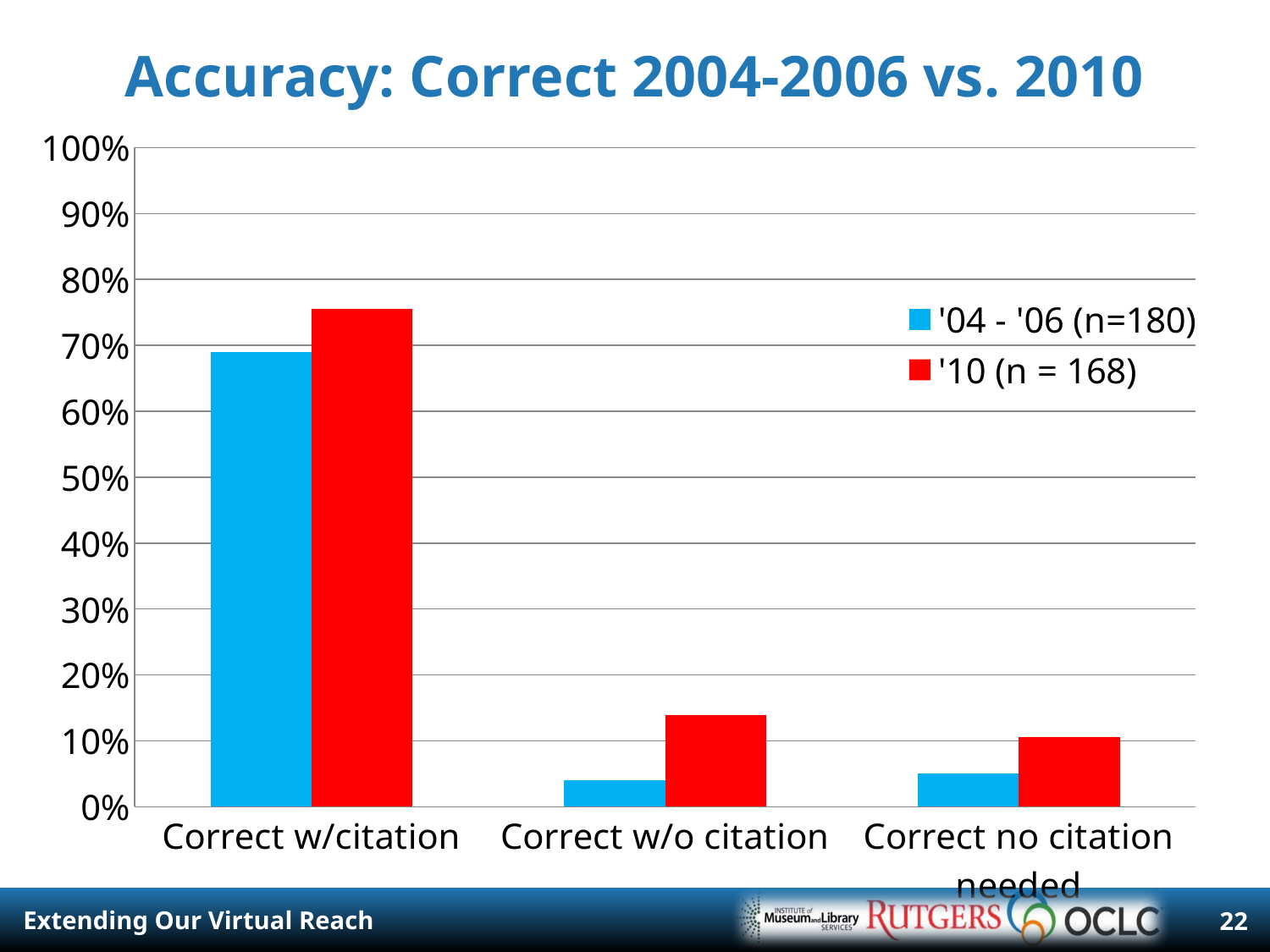
What is the title of the chart? Accuracy: Correct 2004-2006 vs. 2010 Which category has the lowest value for the '10 (n = 168) series? Correct no citation needed Is the value for Correct w/o citation in the '04 - '06 (n=180) series greater or less than 10%? less How many series does the legend list? 2 For Correct w/citation, which series has the larger value, '04 - '06 (n=180) or '10 (n = 168)? '10 (n = 168) How many categories are shown on the x axis? 3 What type of chart is shown on the slide? bar chart Which category has the highest value for the '04 - '06 (n=180) series? Correct w/citation For Correct w/o citation, which series has the larger value, '04 - '06 (n=180) or '10 (n = 168)? '10 (n = 168) Is the value for Correct w/citation in the '04 - '06 (n=180) series greater or less than 60%? greater Which category has the highest value for the '10 (n = 168) series? Correct w/citation Which colour represents the '10 (n = 168) series? red